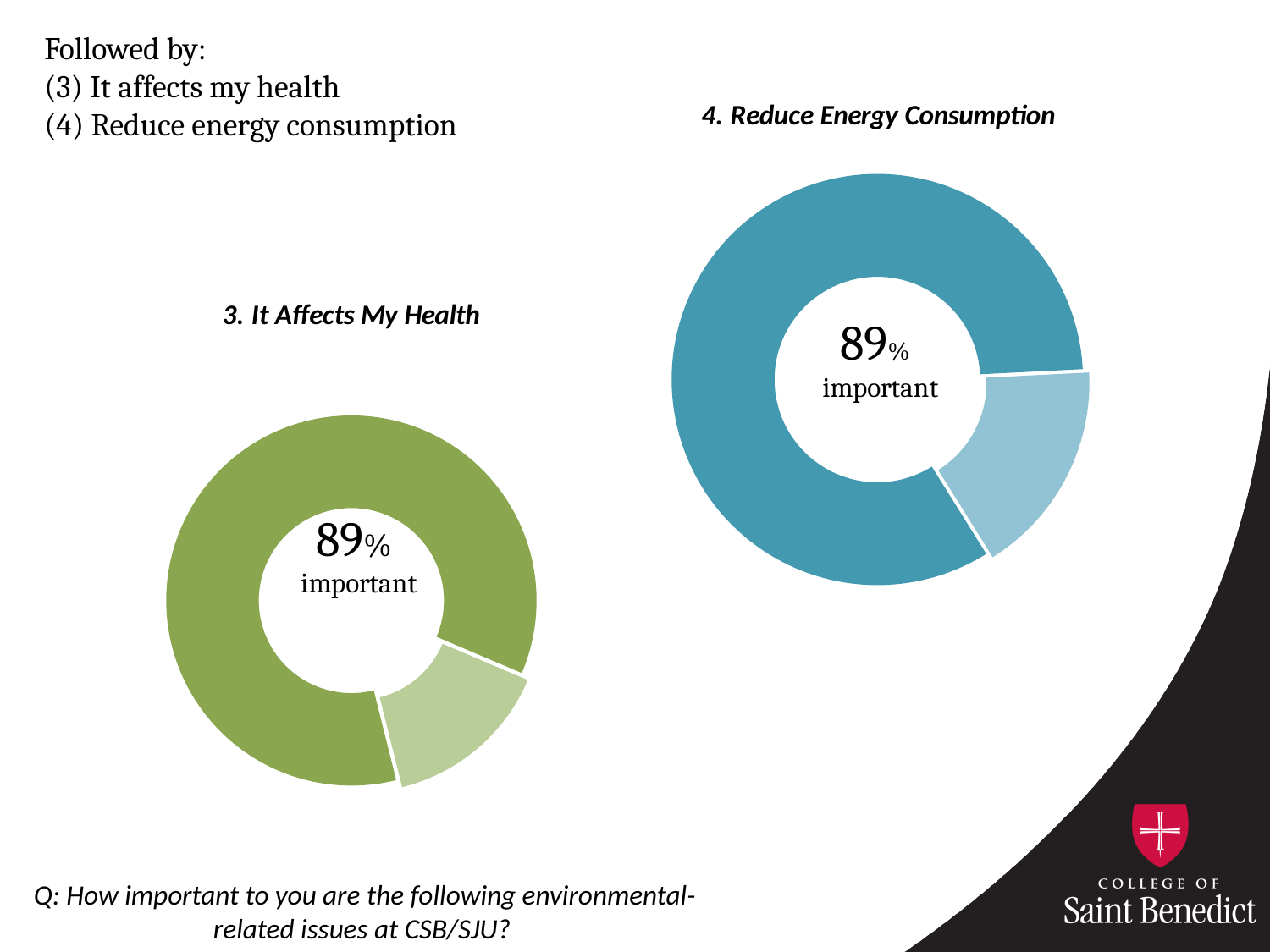
Is the "important" share in the "3. It Affects My Health" chart greater or less than 75%? greater How many slices does the "3. It Affects My Health" chart have? 2 Which chart shows a higher "important" percentage, "3. It Affects My Health" or "4. Reduce Energy Consumption"? They are equal (both 89%) Is the "important" share in the "4. Reduce Energy Consumption" chart greater or less than 50%? greater How many donut charts are shown on the slide? 2 What is the title of the chart on the right side of the slide? 4. Reduce Energy Consumption In the "3. It Affects My Health" chart, what percentage of respondents rated the issue important? 89% What kind of chart is "3. It Affects My Health"? donut (pie) chart In the "3. It Affects My Health" chart, which slice is larger, the "important" slice or the remaining slice? the "important" slice In the "4. Reduce Energy Consumption" chart, what percentage of respondents rated the issue important? 89% How many slices does the "4. Reduce Energy Consumption" chart have? 2 What colour is the "3. It Affects My Health" chart drawn in? green